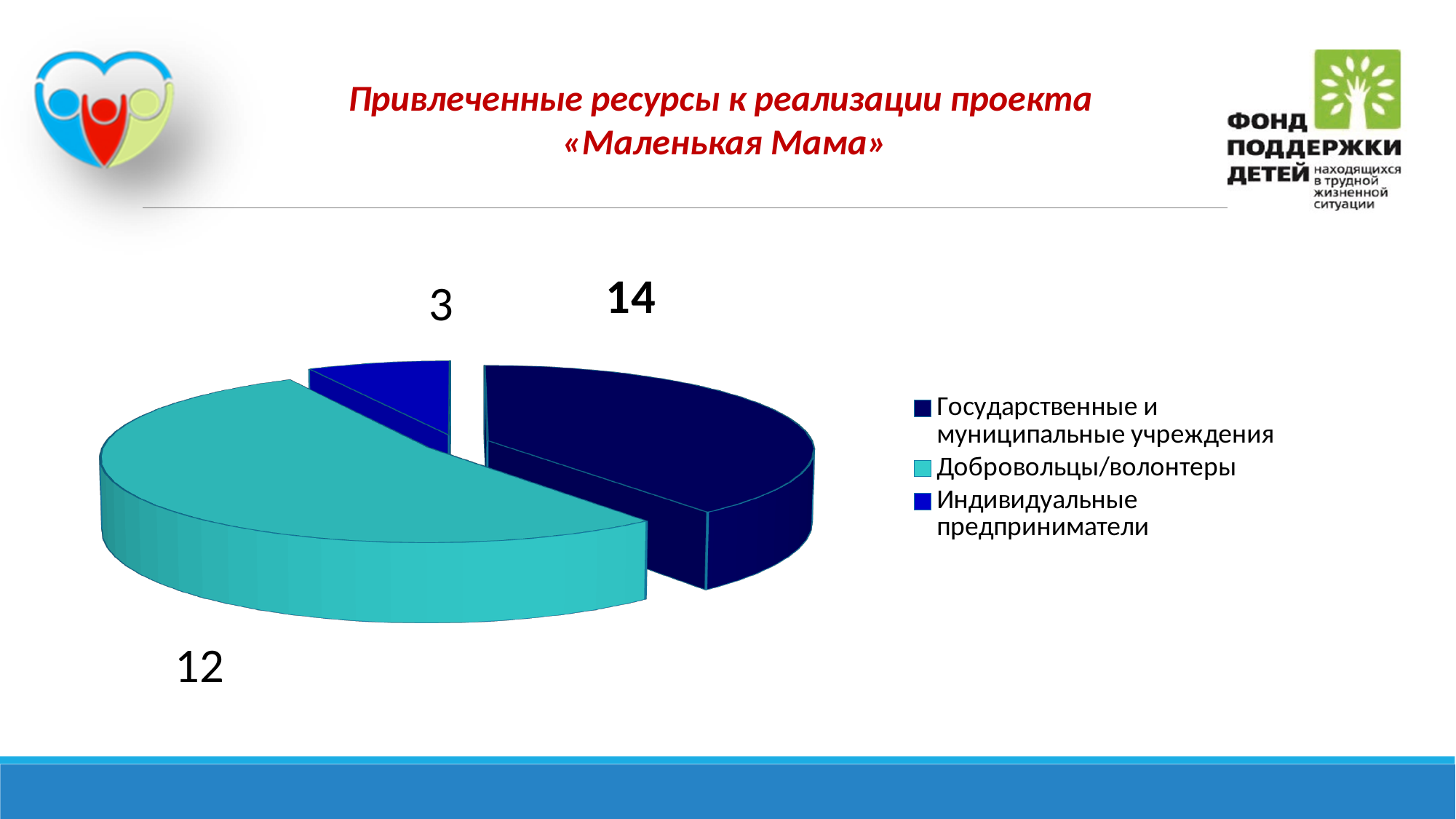
What is the difference between the values for Государственные и муниципальные учреждения and Добровольцы/волонтеры? 2 What is the value for Добровольцы/волонтеры? 12 What is the title of the slide containing the chart? Привлеченные ресурсы к реализации проекта «Маленькая Мама» How many categories does the pie chart have? 3 Which is larger: the value for Добровольцы/волонтеры or the value for Индивидуальные предприниматели? Добровольцы/волонтеры What is the total of all slices in the pie chart? 29 What is the value for Государственные и муниципальные учреждения? 14 What is the value for Индивидуальные предприниматели? 3 What type of chart is shown on the slide? Pie chart Which category has the lowest value? Индивидуальные предприниматели What is the difference between the values for Добровольцы/волонтеры and Индивидуальные предприниматели? 9